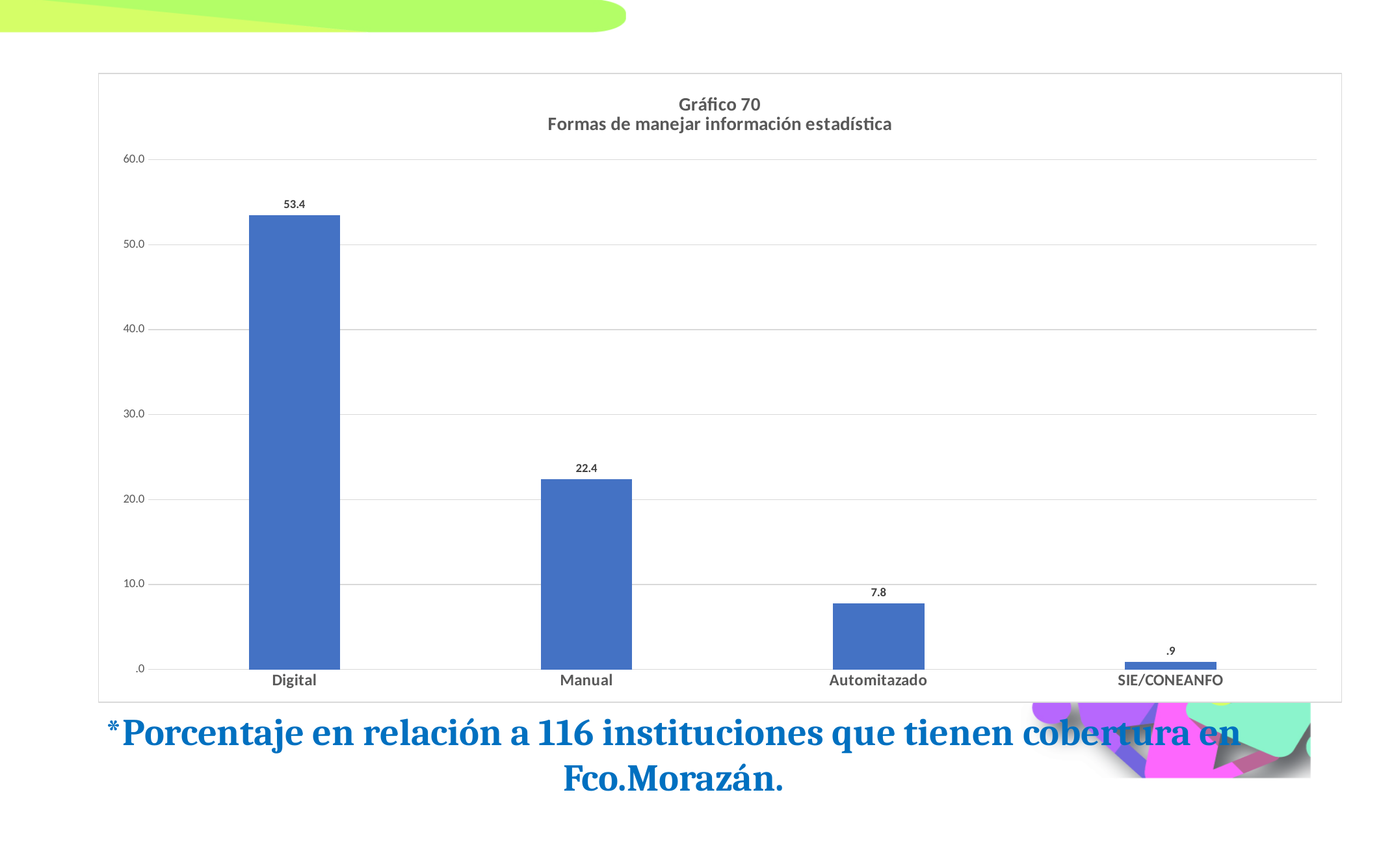
What is the value for Manual? 22.4 What is the title of the chart? Gráfico 70 Formas de manejar información estadística Is the value for Digital greater or less than 50.0? greater What is the value for Automitazado? 7.8 What is the value for Digital? 53.4 What is the value for SIE/CONEANFO? .9 Which category has the lowest value? SIE/CONEANFO Which category has the highest value? Digital What kind of chart is shown on the slide? Bar chart What is the difference between the values for Digital and Manual? 31.0 Which is larger, the value for Manual or the value for Automitazado? Manual How many categories are shown on the x axis? 4